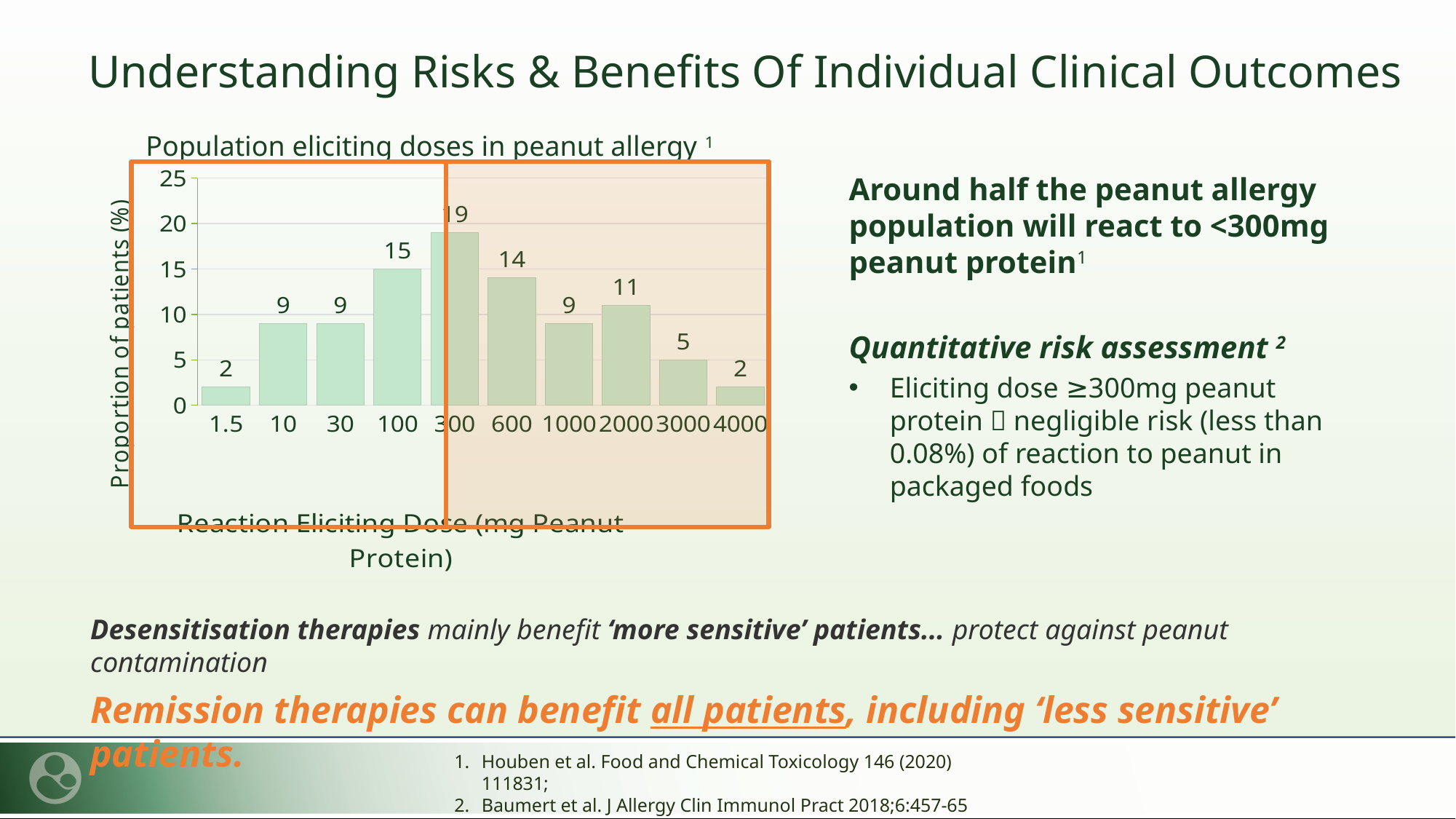
What is the proportion of patients (%) at the 1.5 mg reaction eliciting dose? 2 Which has a larger proportion of patients: the 100 mg dose or the 3000 mg dose? 100 mg Which reaction eliciting dose has the highest proportion of patients? 300 What is the title of the chart? Population eliciting doses in peanut allergy Do the values rise or fall from the 300 mg dose to the 4000 mg dose? Fall What kind of chart is shown on the slide? Bar chart What is the proportion of patients (%) at the 2000 mg reaction eliciting dose? 11 How many reaction eliciting dose categories are shown on the x axis? 10 What is the label of the y axis of the chart? Proportion of patients (%) What is the total proportion of patients (%) for the 1.5, 10, 30 and 100 mg doses combined? 35 What is the difference in proportion of patients between the 300 mg and 600 mg doses? 5 What is the proportion of patients (%) at the 300 mg reaction eliciting dose? 19